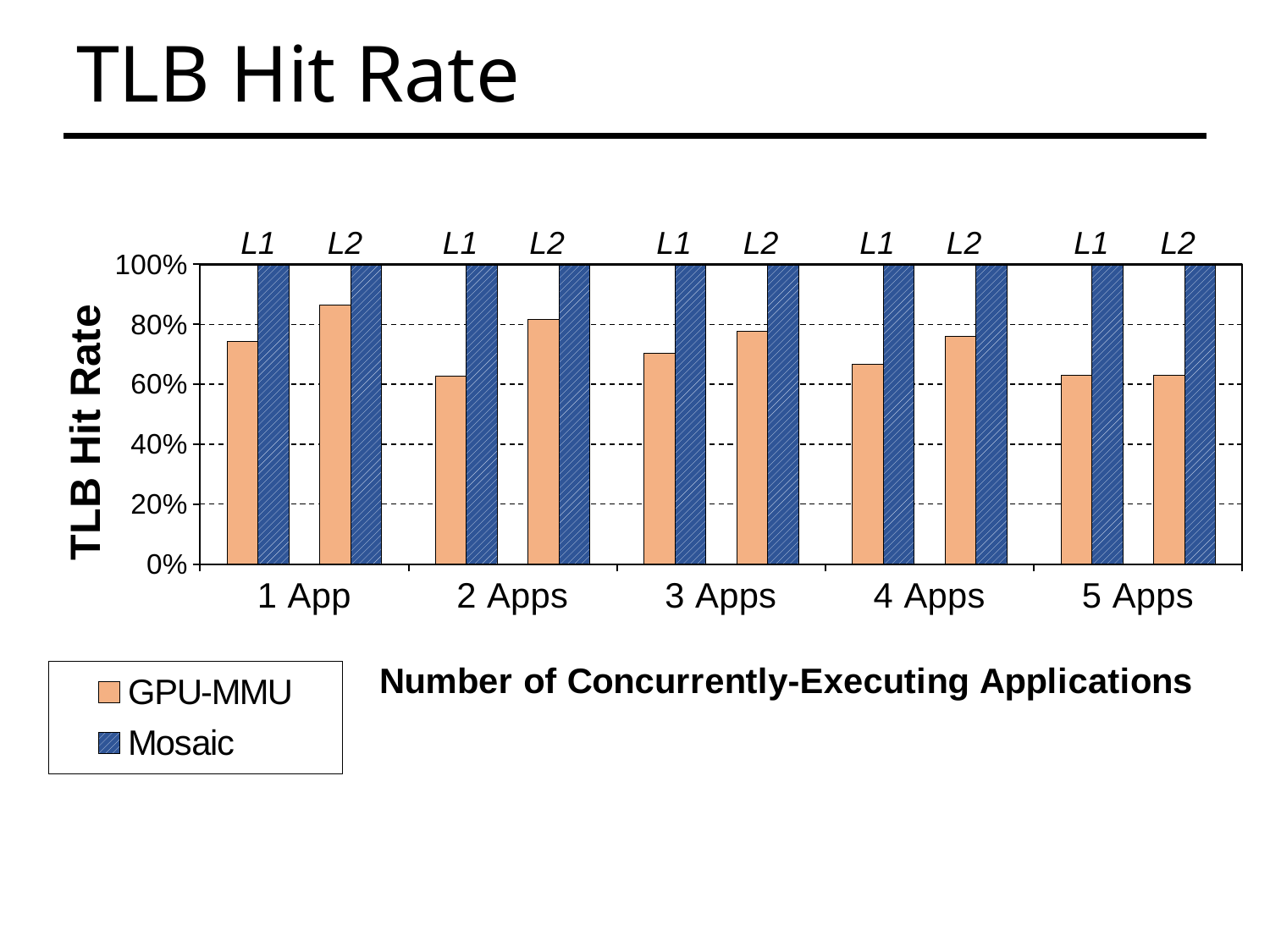
What is the title of the x axis? Number of Concurrently-Executing Applications For 1 App, which GPU-MMU bar is higher, L1 or L2? L2 Is the GPU-MMU L2 hit rate for 1 App greater or less than 80%? greater How many series does the legend list? 2 Does the GPU-MMU L2 hit rate rise or fall as the number of applications increases from 1 App to 5 Apps? fall Which GPU-MMU bar has the highest TLB hit rate? 1 App L2 Is the GPU-MMU L1 hit rate for 2 Apps greater or less than 80%? less How many application-count categories are shown on the x axis? 5 What kind of chart is shown on the slide? bar chart Is the GPU-MMU L1 hit rate for 5 Apps greater or less than 60%? greater